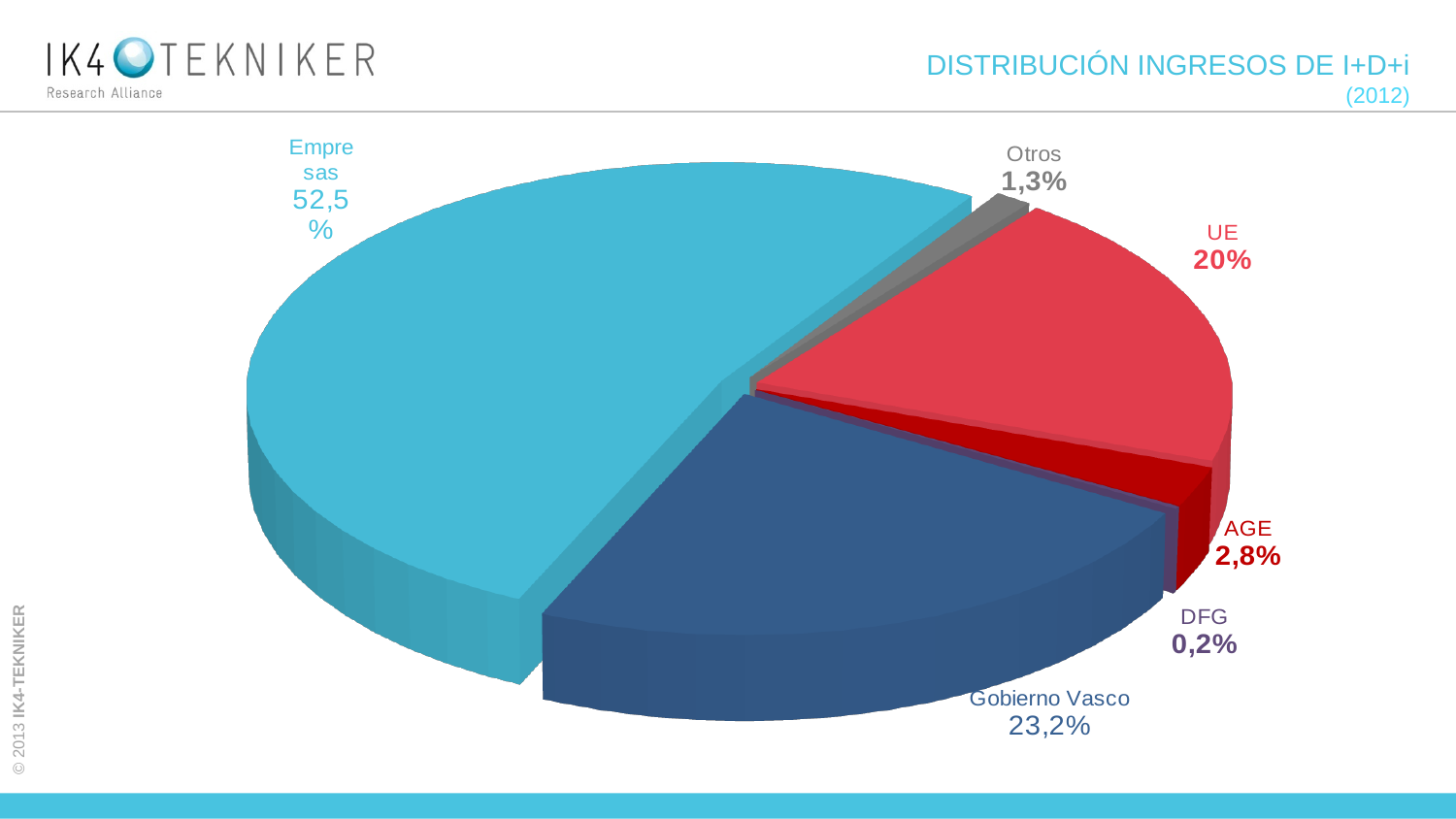
What is the value shown for Otros? 1,3% What is the value shown for AGE? 2,8% Which category has the largest slice of the pie? Empresas What kind of chart is shown on the slide? pie chart How many slices does the pie chart have? 6 What is the value shown for Gobierno Vasco? 23,2% What is the value shown for UE? 20% What is the difference in percentage points between Empresas and Gobierno Vasco? 29,3 What is the value shown for DFG? 0,2% What share of the pie does Empresas have? 52,5% Which category has the smallest slice of the pie? DFG Which is larger, Gobierno Vasco or UE? Gobierno Vasco